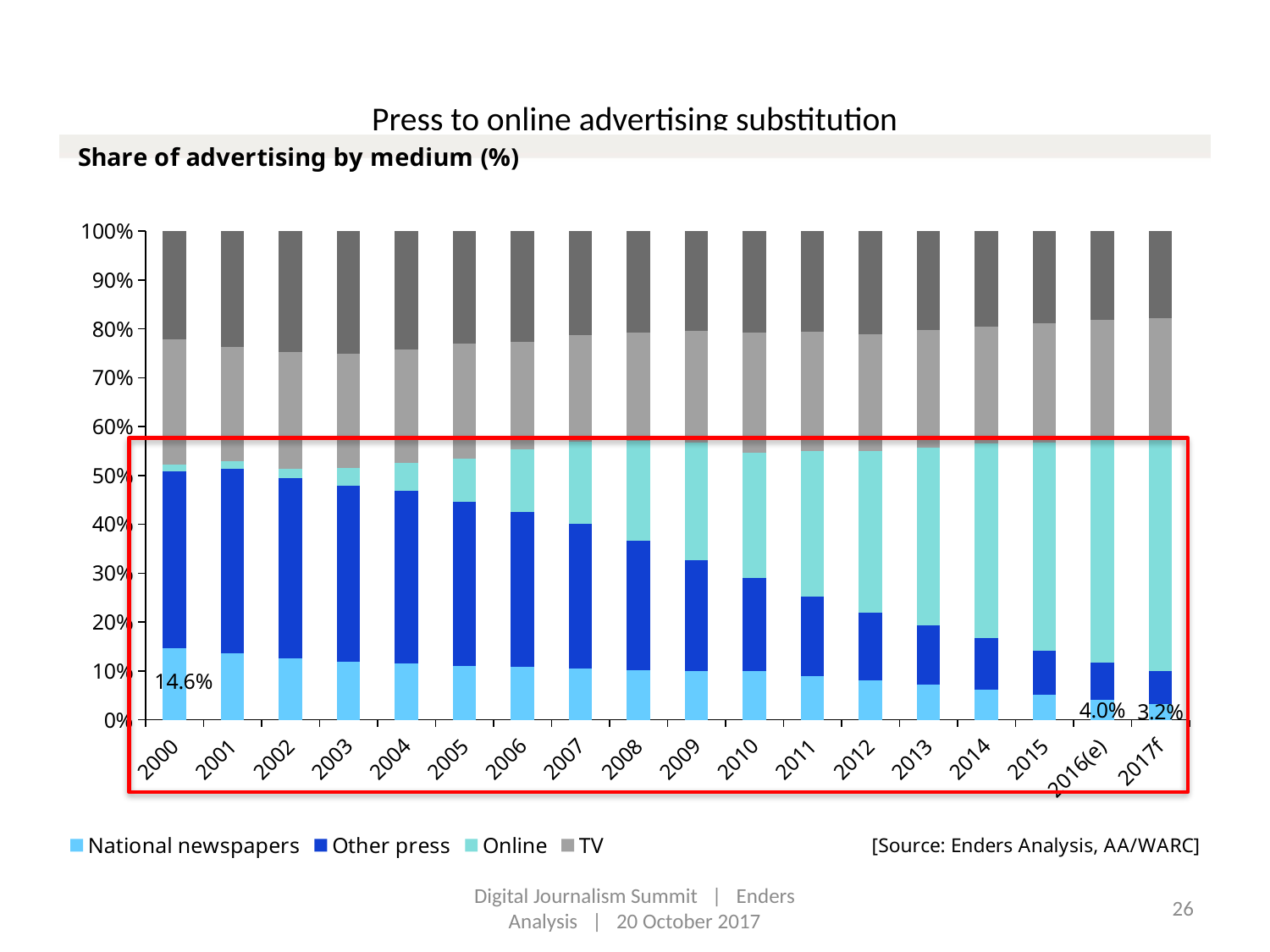
What is the difference between the National newspapers share in 2016(e) and in 2017f? 0.8 percentage points What kind of chart is shown on the slide? Stacked bar chart Which is larger, the Other press share in 2000 or in 2017f? 2000 What is the share of advertising for National newspapers in 2017f? 3.2% Is the Online share in 2017f greater or less than 40%? greater What is the share of advertising for National newspapers in 2016(e)? 4.0% How many years (categories) are shown on the x axis? 18 What is the source cited for the chart? Enders Analysis, AA/WARC What is the share of advertising for National newspapers in 2000? 14.6% How many series does the legend list? 4 Does the National newspapers share rise or fall from 2000 to 2017f? Fall By how many percentage points does the National newspapers share fall between 2000 and 2017f? 11.4 percentage points